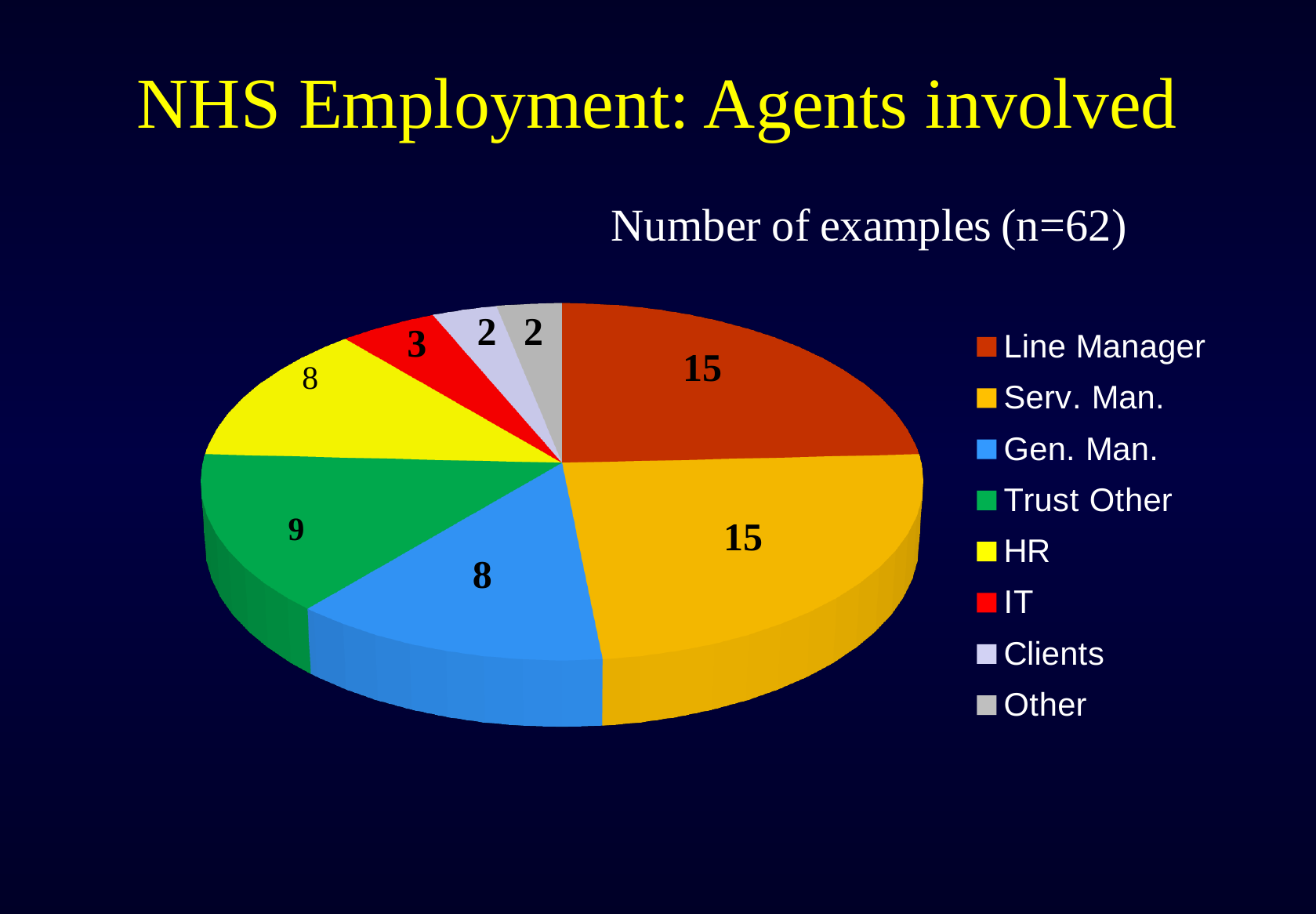
What is the value for Trust Other? 9 What is the difference between the values for Line Manager and IT? 12 What is the value for Gen. Man.? 8 How many examples are attributed to Line Manager? 15 What type of chart is shown on the slide? pie chart How many categories does the pie chart have? 8 What is the value for Clients? 2 Which is larger, IT or Clients? IT What is the title of the slide? NHS Employment: Agents involved Which is larger, Trust Other or Gen. Man.? Trust Other What is the difference between the values for Serv. Man. and HR? 7 What is the value for IT? 3